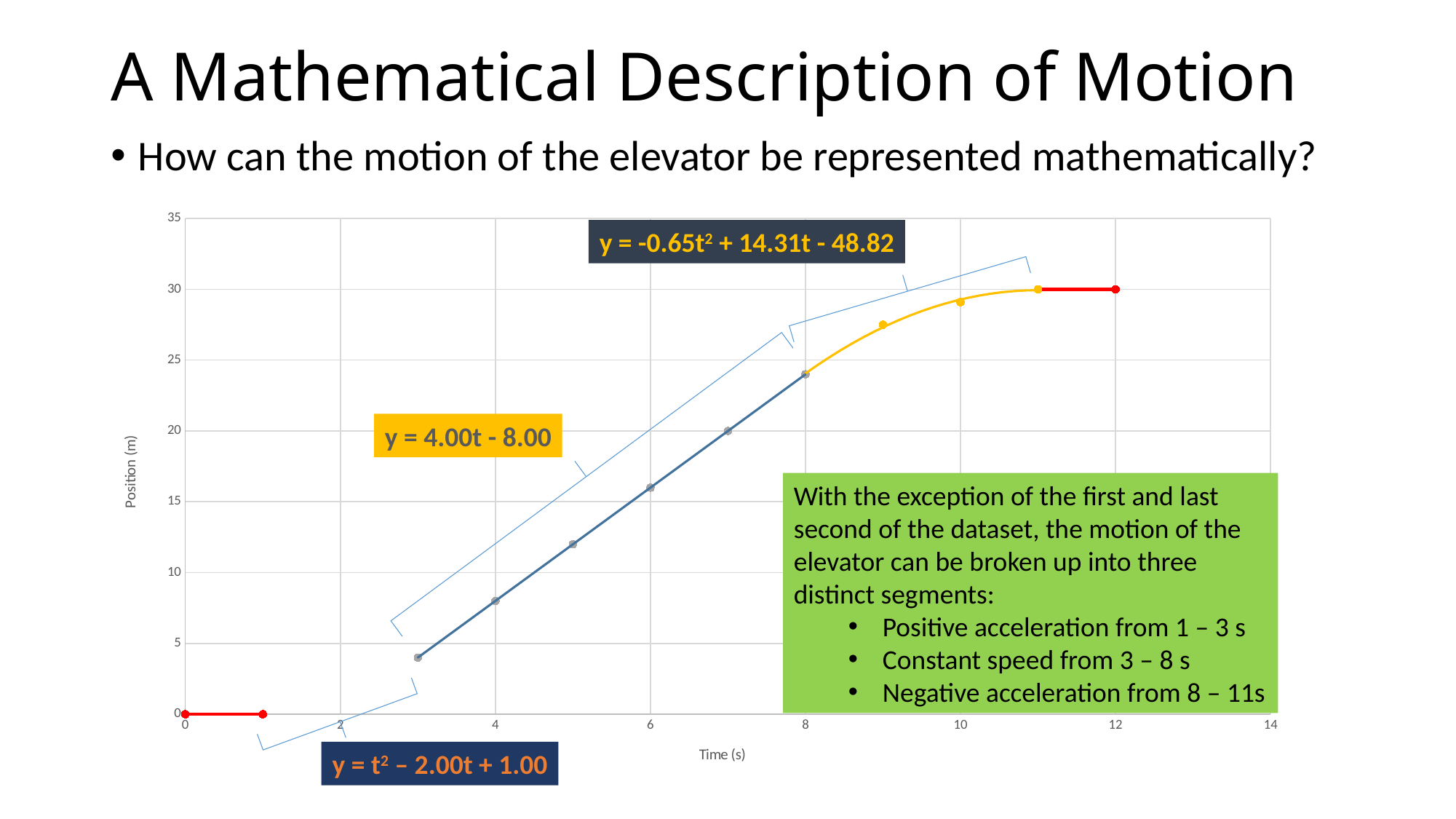
What equation is shown for the constant-speed segment of the chart? y = 4.00t - 8.00 Is the position at 9 s greater or less than 25? greater Is the position at 4 s greater or less than 10? less What is the position at 7 s? 20 What is the difference between the position at 12 s and the position at 7 s? 10 Does the position rise or fall as time increases from 3 s to 8 s? rises What is the position at 0 s? 0 What is the highest position value reached on the chart? 30 What kind of chart is shown on the slide? line chart What is the position at 12 s? 30 Is the position at 3 s greater or less than 5? less Which is larger, the position at 8 s or the position at 4 s? 8 s